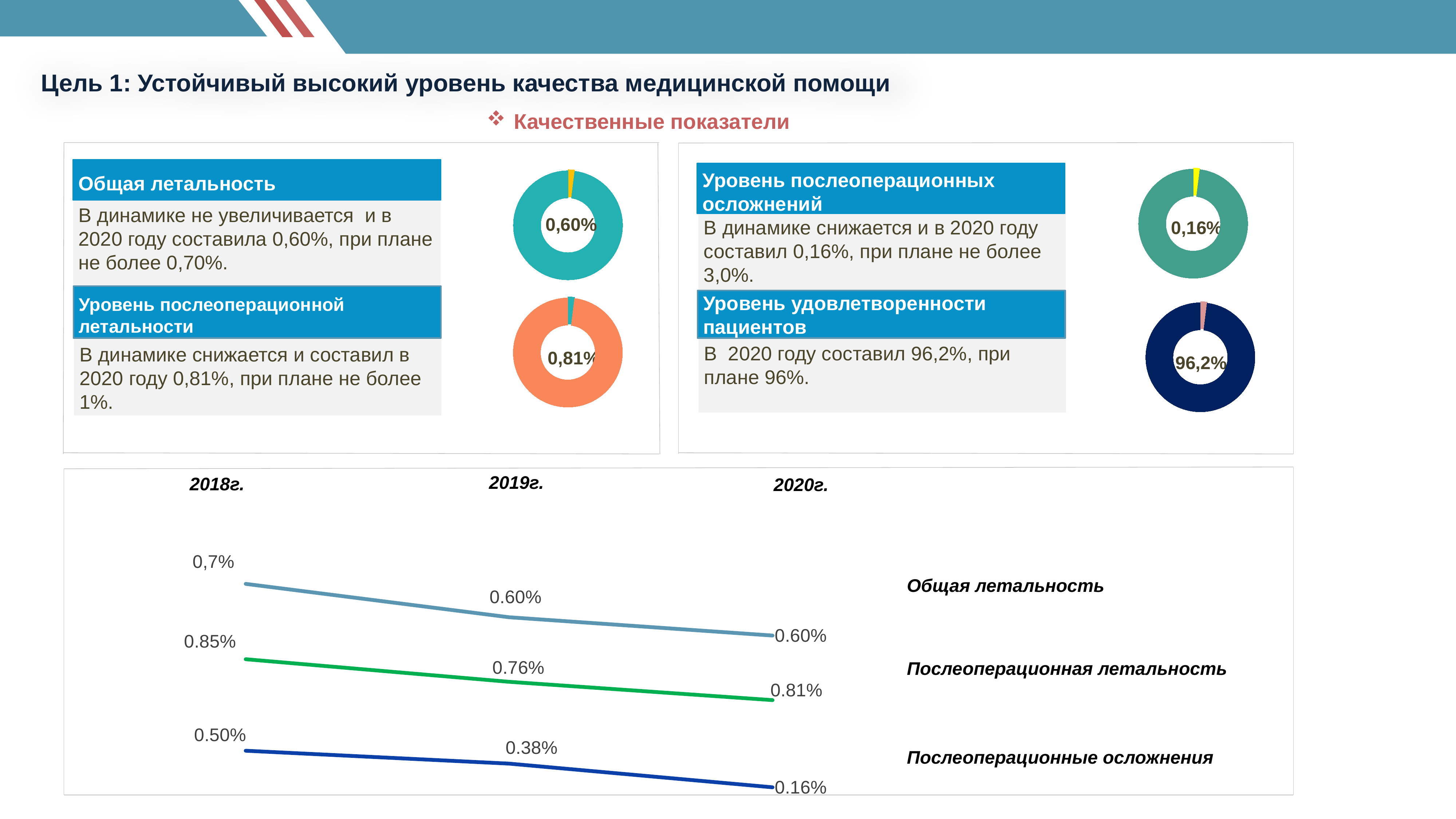
What value is shown in the donut chart for Уровень удовлетворенности пациентов? 96,2% In the bottom line chart, what is the difference between the Послеоперационные осложнения values for 2018г. and 2020г.? 0.34% In the bottom line chart, what is the value for Общая летальность in 2018г.? 0,7% In the bottom line chart, what is the value for Послеоперационная летальность in 2019г.? 0.76% In the bottom line chart, what is the value for Послеоперационные осложнения in 2020г.? 0.16% In the bottom line chart, which is larger for Послеоперационная летальность: the 2019г. value or the 2020г. value? 2020г. In the bottom line chart, in which year is Послеоперационные осложнения highest? 2018г. In the bottom line chart, in which year is Послеоперационная летальность lowest? 2019г. In the bottom line chart, how many series (lines) are plotted? 3 In the bottom line chart, how many years are shown on the x axis? 3 In the bottom line chart, does Послеоперационные осложнения rise or fall from 2018г. to 2020г.? Fall What kind of chart is shown at the bottom of the slide? Line chart